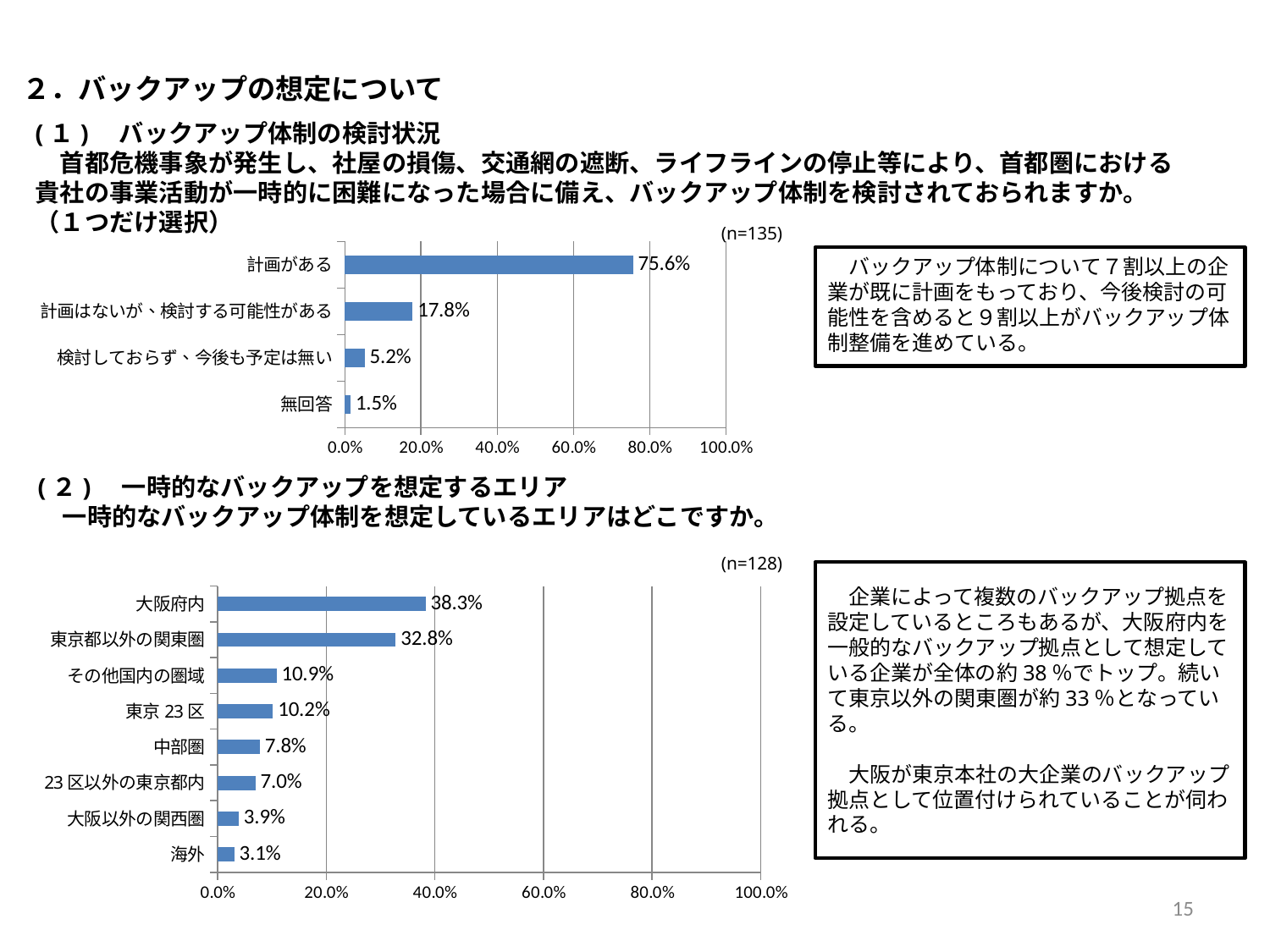
In the top chart (バックアップ体制の検討状況), what is the value for 計画がある? 75.6% In the top chart (バックアップ体制の検討状況), which category has the lowest value? 無回答 In the bottom chart (一時的なバックアップを想定するエリア), which category has the highest value? 大阪府内 In the top chart (バックアップ体制の検討状況), what is the value for 計画はないが、検討する可能性がある? 17.8% In the bottom chart (一時的なバックアップを想定するエリア), how many categories are shown? 8 In the bottom chart (一時的なバックアップを想定するエリア), what is the difference between 大阪府内 and 東京都以外の関東圏? 5.5% What kind of chart is the bottom chart (一時的なバックアップを想定するエリア)? Bar chart In the bottom chart (一時的なバックアップを想定するエリア), what is the value for 東京 23 区? 10.2% In the bottom chart (一時的なバックアップを想定するエリア), which is larger, 中部圏 or 23 区以外の東京都内? 中部圏 In the bottom chart (一時的なバックアップを想定するエリア), what is the value for 大阪府内? 38.3% In the top chart (バックアップ体制の検討状況), how many categories are shown? 4 In the top chart (バックアップ体制の検討状況), what is the difference between 計画がある and 計画はないが、検討する可能性がある? 57.8%